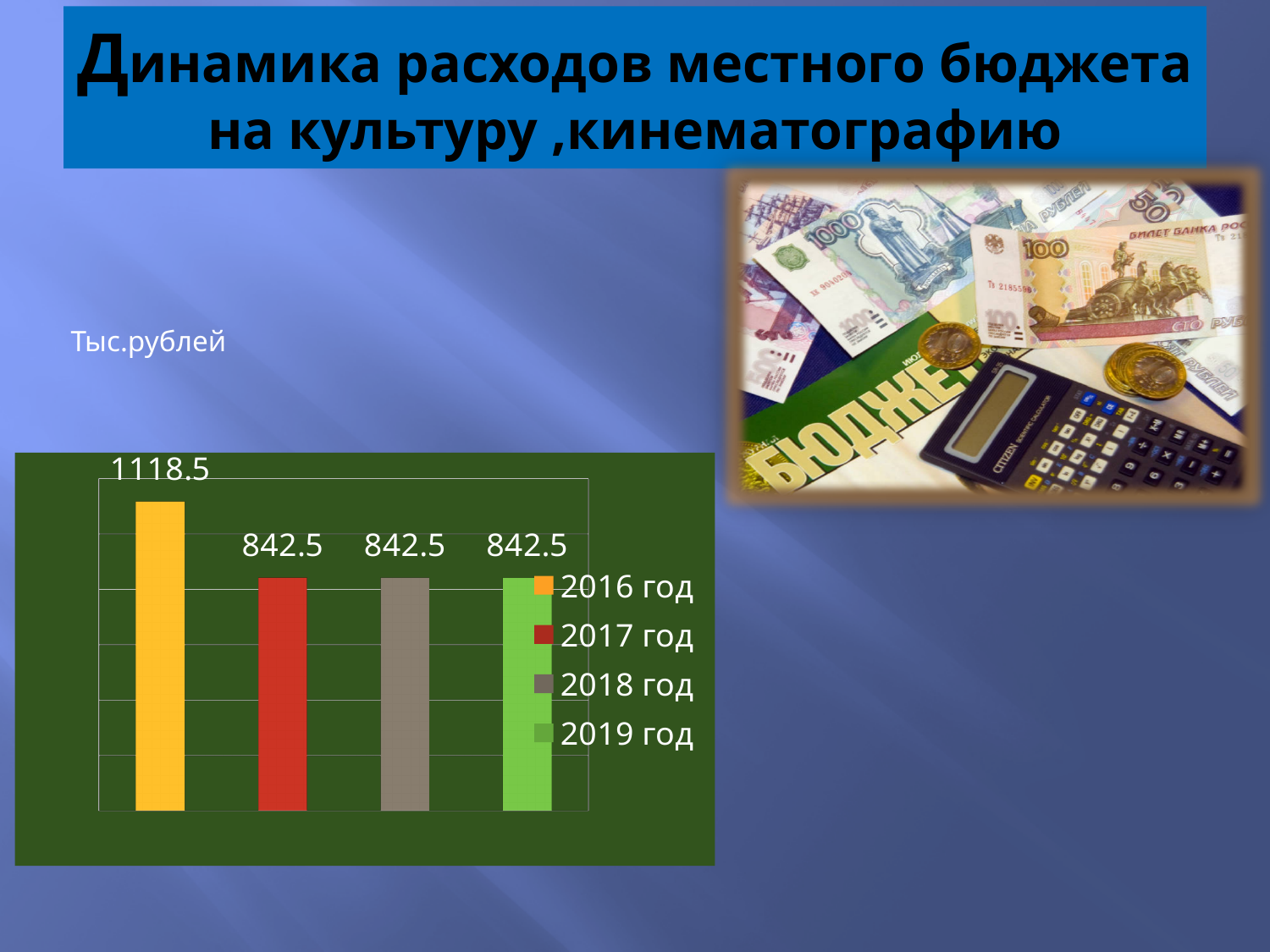
What unit is stated above the chart? Тыс.рублей How many entries does the legend list? 4 Do the values rise or fall from 2016 год to 2017 год? fall What kind of chart is shown on the slide? bar chart What colour is the bar for 2017 год? red What is the value for 2019 год? 842.5 Which year has the highest value? 2016 год What is the value for 2017 год? 842.5 What is the difference between the values for 2016 год and 2017 год? 276 Which is larger, the value for 2016 год or the value for 2018 год? 2016 год How many bars are plotted in the chart? 4 What is the value for 2016 год? 1118.5